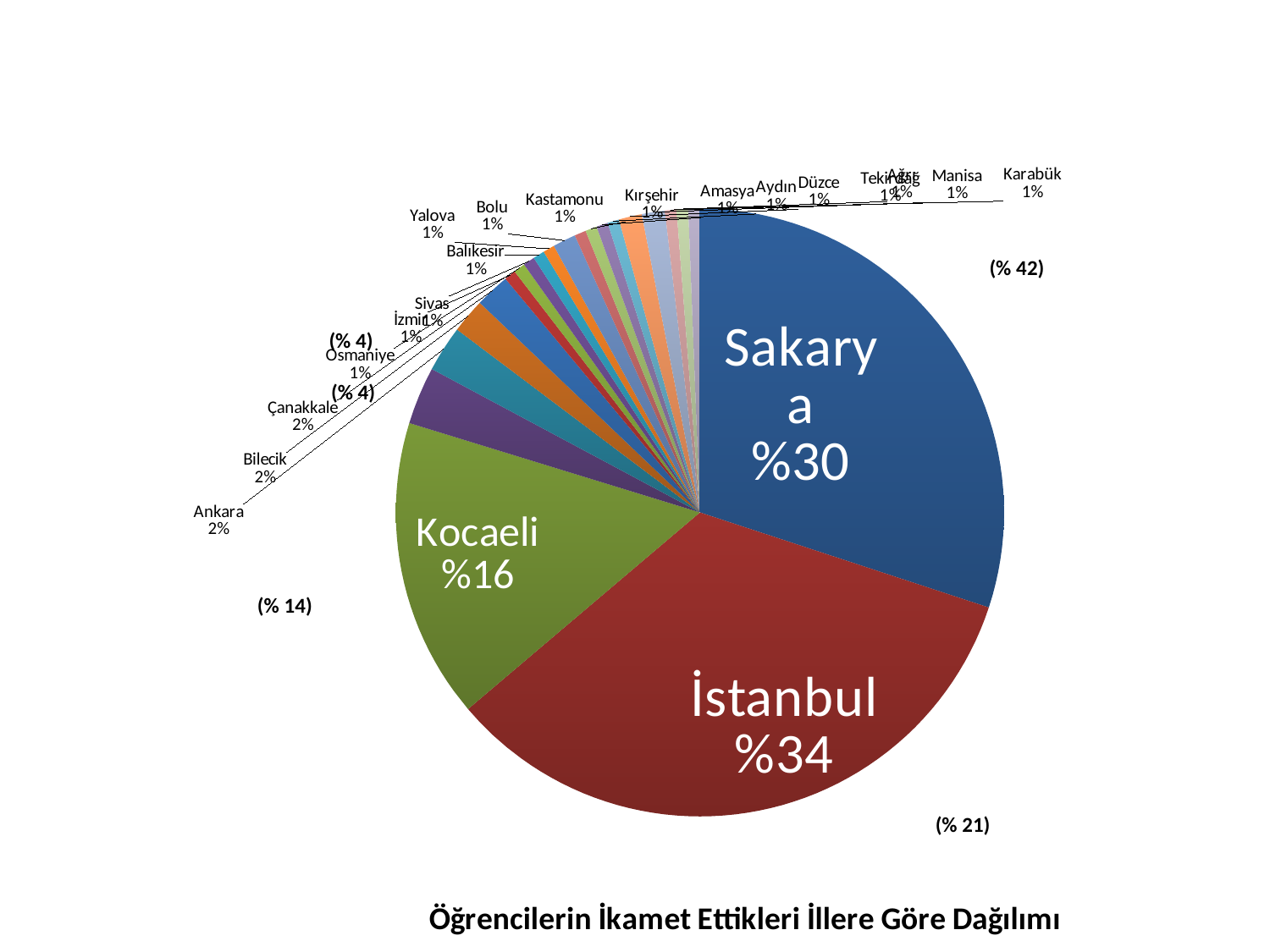
What is the value shown for Sakarya? %30 What is the value shown for Ankara? 2% Which province has the largest slice of the pie? İstanbul What is the value shown for Bolu? 1% What share of the pie does İstanbul have? %34 What percentage is shown for Kocaeli? %16 Which is larger, the slice for Sakarya or the slice for Kocaeli? Sakarya By how many percentage points does İstanbul exceed Sakarya? 4 What kind of chart is shown on the slide? Pie chart What is the title of the chart? Öğrencilerin İkamet Ettikleri İllere Göre Dağılımı What colour is the İstanbul slice? Red What is the combined share of Sakarya, İstanbul and Kocaeli? 80%